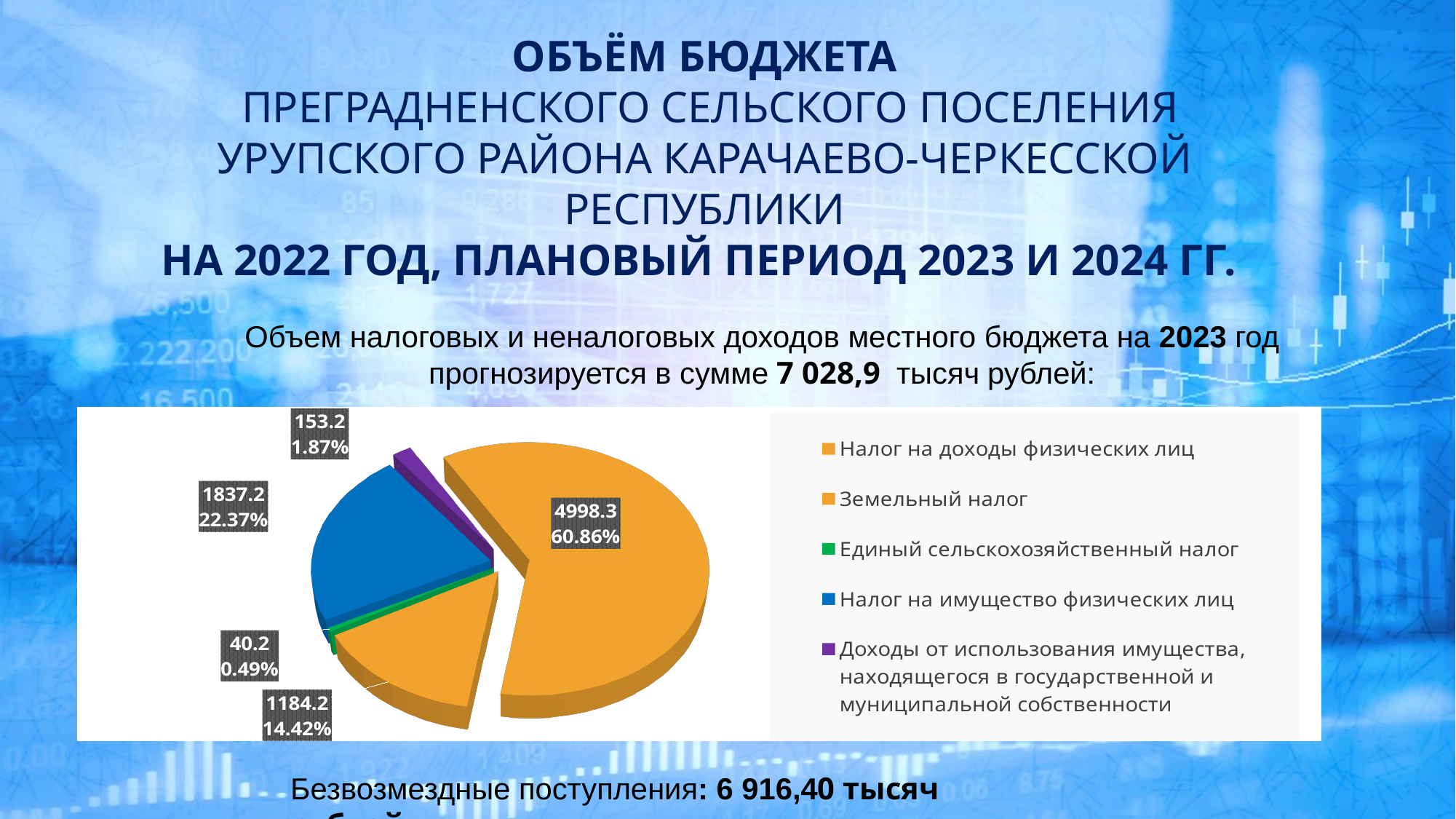
What colour is the slice for Налог на имущество физических лиц? blue What is the value shown for Земельный налог? 1184.2 What kind of chart is shown on the slide? pie chart Which is larger: the value for Доходы от использования имущества, находящегося в государственной и муниципальной собственности or the value for Единый сельскохозяйственный налог? Доходы от использования имущества, находящегося в государственной и муниципальной собственности What share of the pie does Единый сельскохозяйственный налог represent? 0.49% What is the value shown for Налог на доходы физических лиц? 4998.3 What share of the pie does Налог на имущество физических лиц represent? 22.37% Which category has the largest slice of the pie? Налог на доходы физических лиц What is the difference between the values for Налог на имущество физических лиц and Земельный налог? 653.0 How many slices does the pie chart have? 5 Which category has the smallest slice of the pie? Единый сельскохозяйственный налог How many entries does the legend of the pie chart list? 5